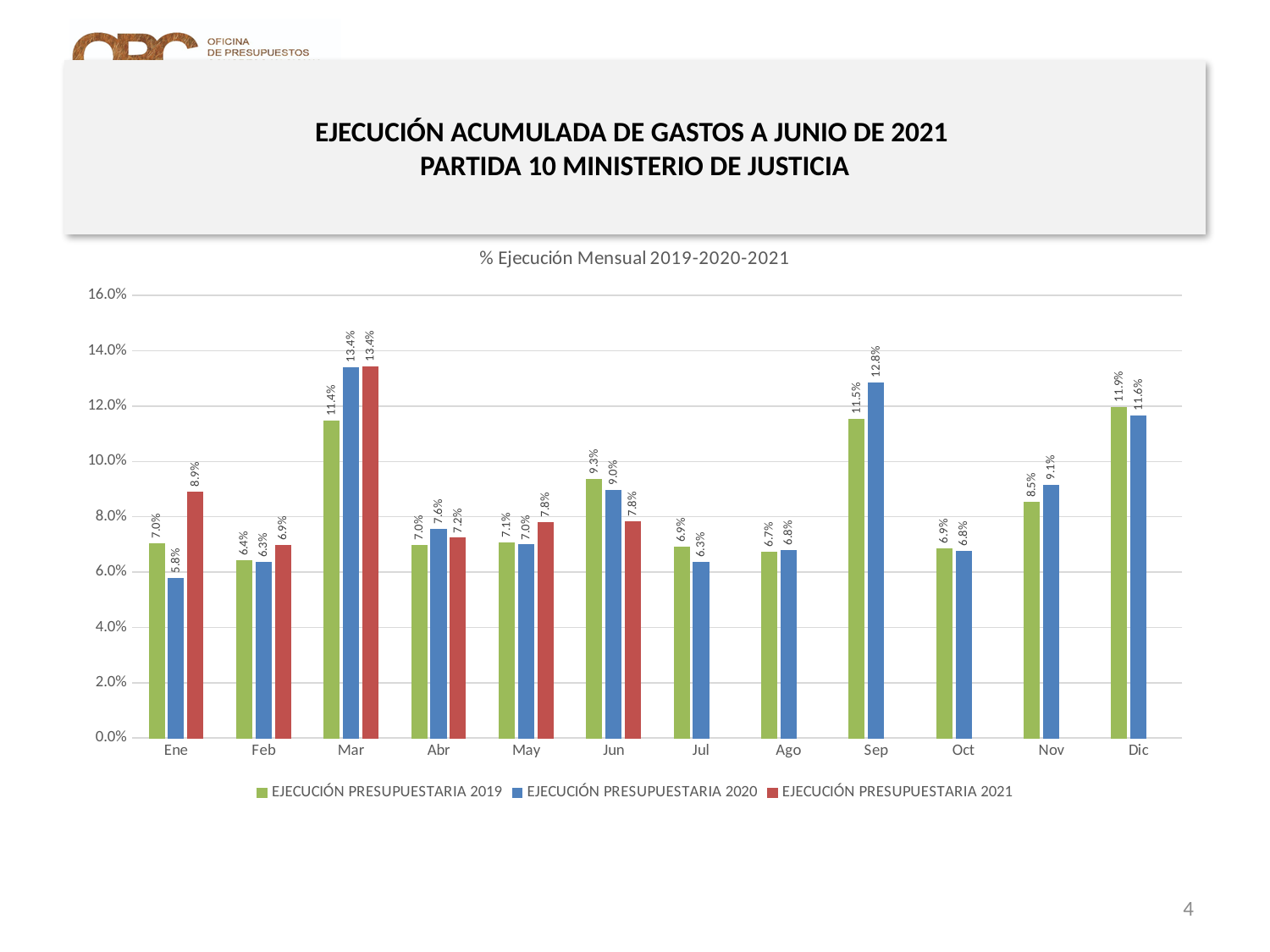
How many series does the legend list? 3 What is the value for EJECUCIÓN PRESUPUESTARIA 2021 in Ene? 8.9% What is the value for EJECUCIÓN PRESUPUESTARIA 2019 in Dic? 11.9% In which month is the EJECUCIÓN PRESUPUESTARIA 2020 value lowest? Ene What is the difference between the EJECUCIÓN PRESUPUESTARIA 2020 and EJECUCIÓN PRESUPUESTARIA 2019 values in Mar? 2.0% What is the title of the chart? % Ejecución Mensual 2019-2020-2021 What is the value for EJECUCIÓN PRESUPUESTARIA 2020 in Sep? 12.8% In which month is the EJECUCIÓN PRESUPUESTARIA 2019 value highest? Dic How many months are shown on the x axis? 12 Which is larger in Jun: the EJECUCIÓN PRESUPUESTARIA 2019 value or the EJECUCIÓN PRESUPUESTARIA 2021 value? EJECUCIÓN PRESUPUESTARIA 2019 What kind of chart is shown on the slide? Bar chart Is the value for EJECUCIÓN PRESUPUESTARIA 2020 in Nov greater or less than 8.0%? greater